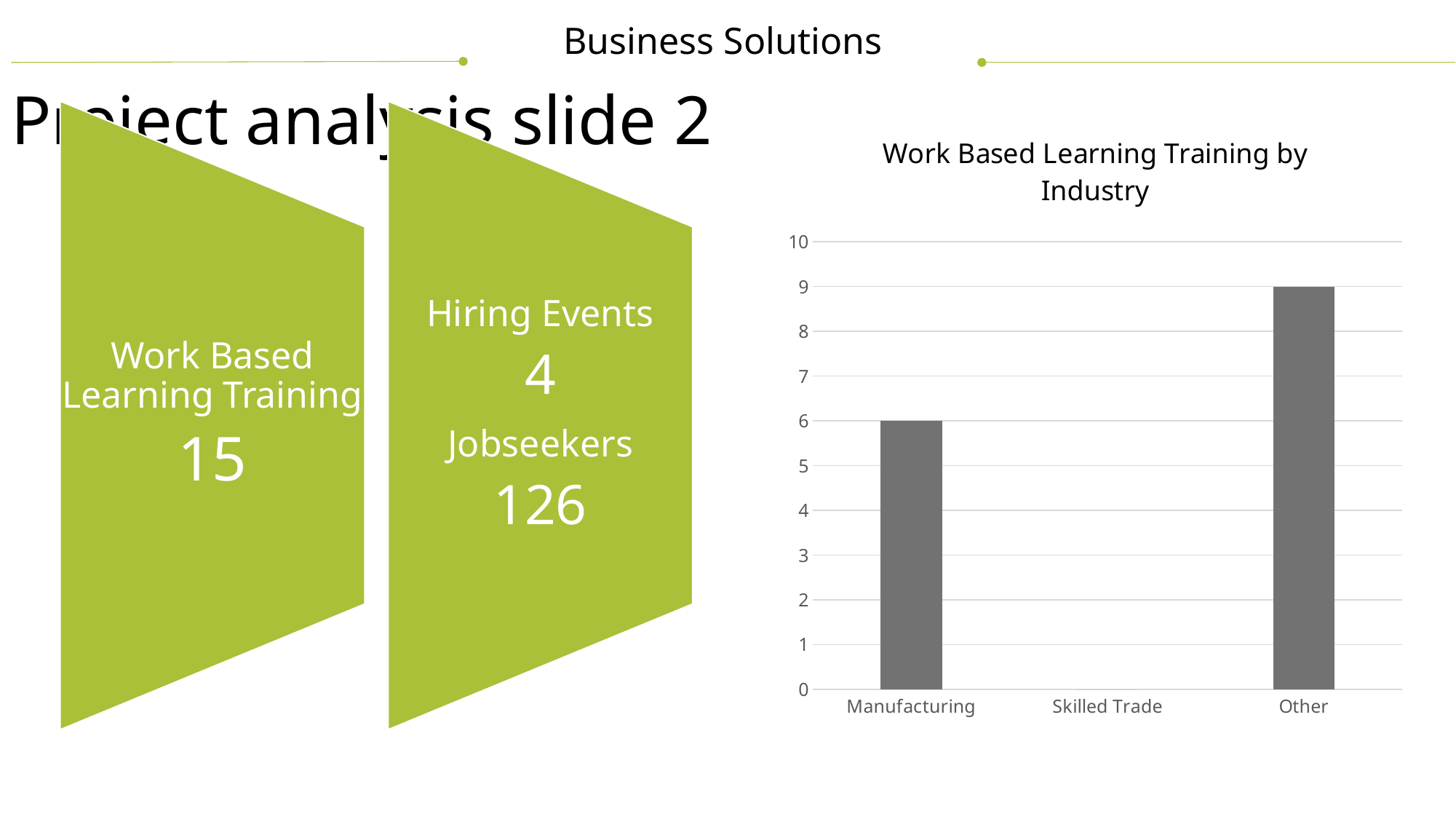
Is the value for Other greater or less than 8? greater What is the value for Other in the chart? 9 Is the value for Manufacturing greater or less than 5? greater What is the value for Manufacturing in the chart? 6 How many industry categories are shown on the x axis of the chart? 3 Which is larger, the value for Manufacturing or the value for Other? Other What is the highest value shown on the chart's vertical axis? 10 Which industry has the highest value in the chart? Other What is the difference between the values for Other and Manufacturing? 3 What is the title of the chart? Work Based Learning Training by Industry What kind of chart is shown on the slide? bar chart